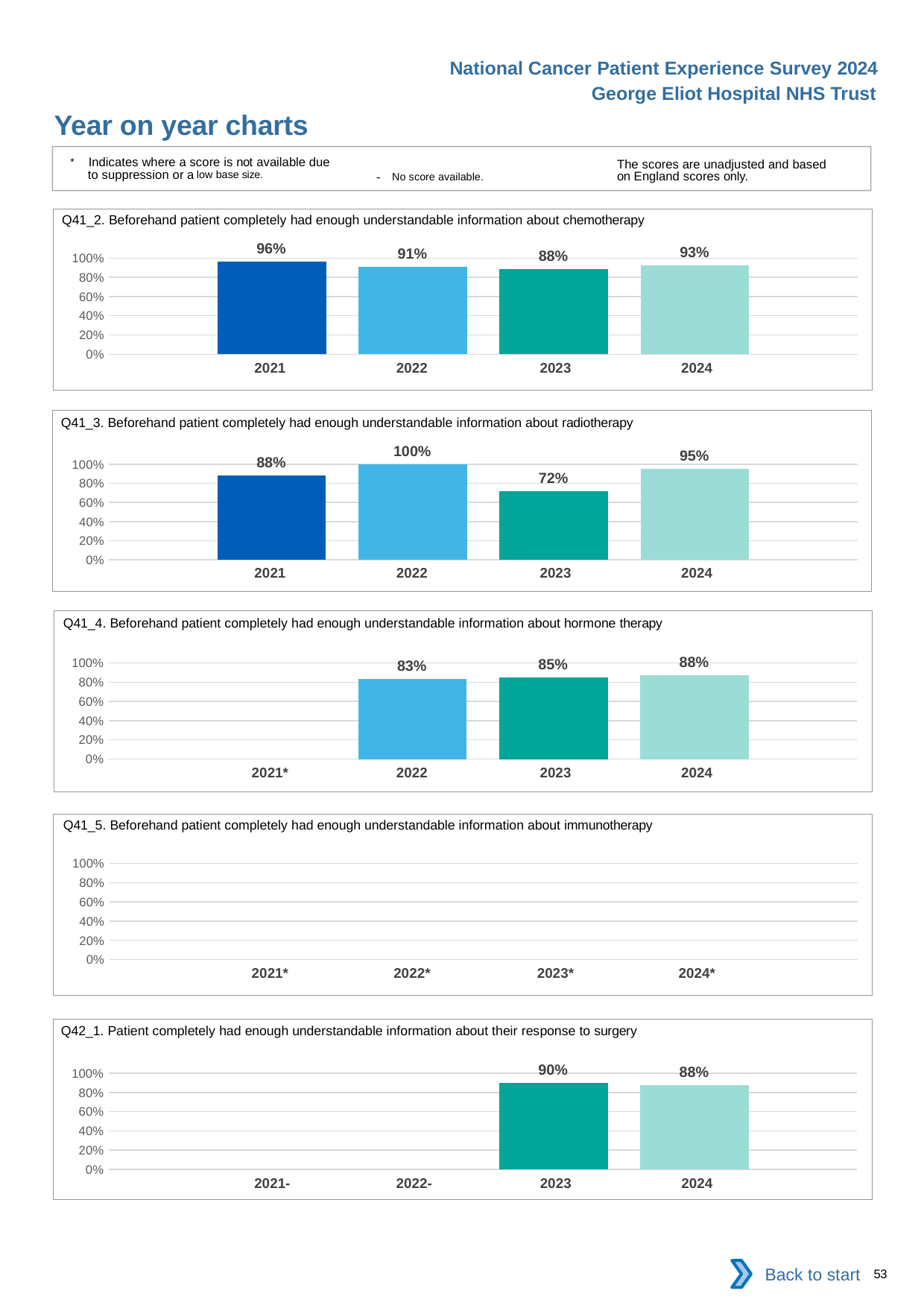
In the Q41_3 radiotherapy chart, what is the difference between the 2024 and 2023 values? 23 percentage points In the Q41_2 chemotherapy chart, what is the value for 2021? 96% In the Q41_5 immunotherapy chart, how many bars are plotted? 0 In the Q41_2 chemotherapy chart, which year has the lowest value? 2023 In the Q41_4 hormone therapy chart, what is the value for 2024? 88% In the Q42_1 surgery chart, which is larger, the 2023 value or the 2024 value? 2023 In the Q41_4 hormone therapy chart, how many bars are plotted? 3 In the Q41_4 hormone therapy chart, do the values rise or fall from 2022 to 2024? rise In the Q42_1 surgery chart, what is the value for 2023? 90% What kind of chart is the Q41_2 chemotherapy chart? bar chart In the Q41_3 radiotherapy chart, what is the value for 2022? 100% In the Q41_3 radiotherapy chart, which year has the lowest value? 2023